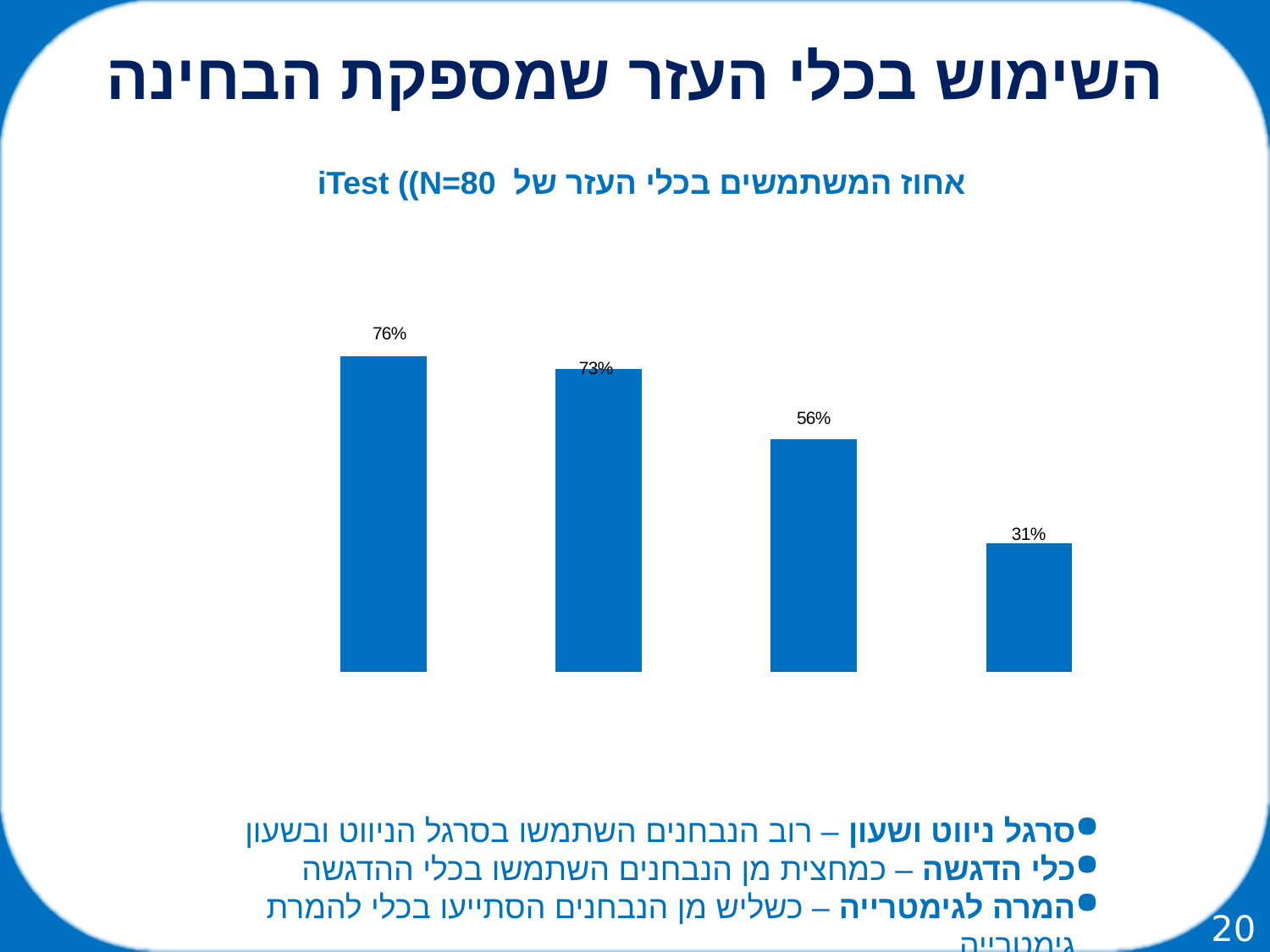
Which is larger, the third bar from the left or the rightmost bar? the third bar from the left What type of chart is shown on the slide? bar chart What is the difference between the leftmost bar and the rightmost bar? 45% What is the value shown on the third bar from the left? 56% What is the lowest value shown in the chart? 31% What sample size (N) is stated in the chart title? N=80 What is the value shown on the rightmost bar? 31% What is the value shown on the second bar from the left? 73% Do the bar values rise or fall from left to right? fall How many bars are plotted in the chart? 4 What is the highest value shown in the chart? 76% What is the value shown on the leftmost bar? 76%